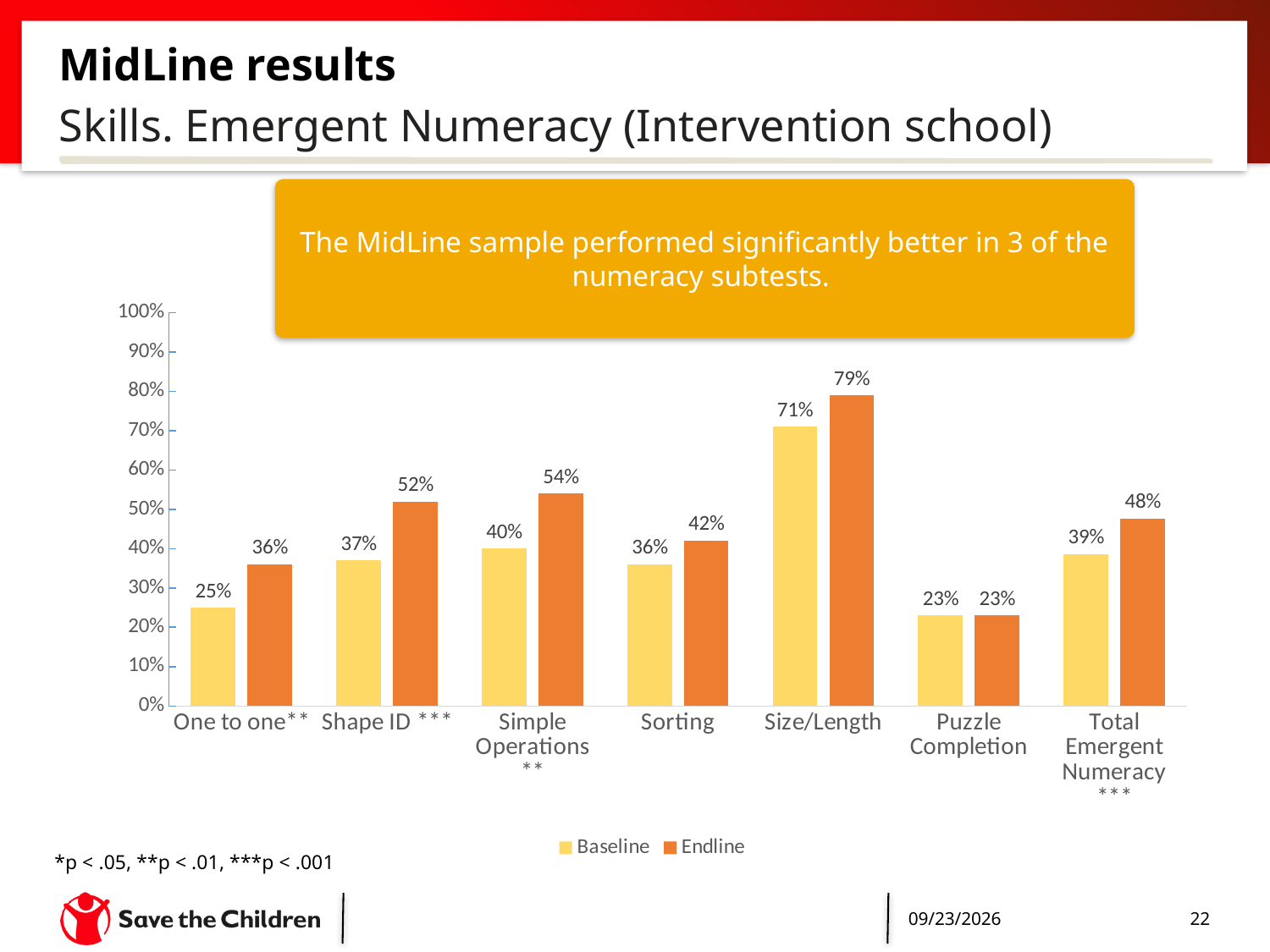
Which is larger for One to one, the Baseline value or the Endline value? Endline What is the difference between the Endline and Baseline values for Simple Operations? 14% What are the two series named in the legend? Baseline and Endline How many series does the legend list? 2 What is the difference between the Endline value for Size/Length and the Endline value for Puzzle Completion? 56% What is the Endline value for Shape ID? 52% What kind of chart is shown on the slide? Bar chart What is the Baseline value for Size/Length? 71% Which category has the highest Endline value? Size/Length Which category has the lowest Baseline value? Puzzle Completion What is the Baseline value for Total Emergent Numeracy? 39% How many categories are shown on the x axis? 7